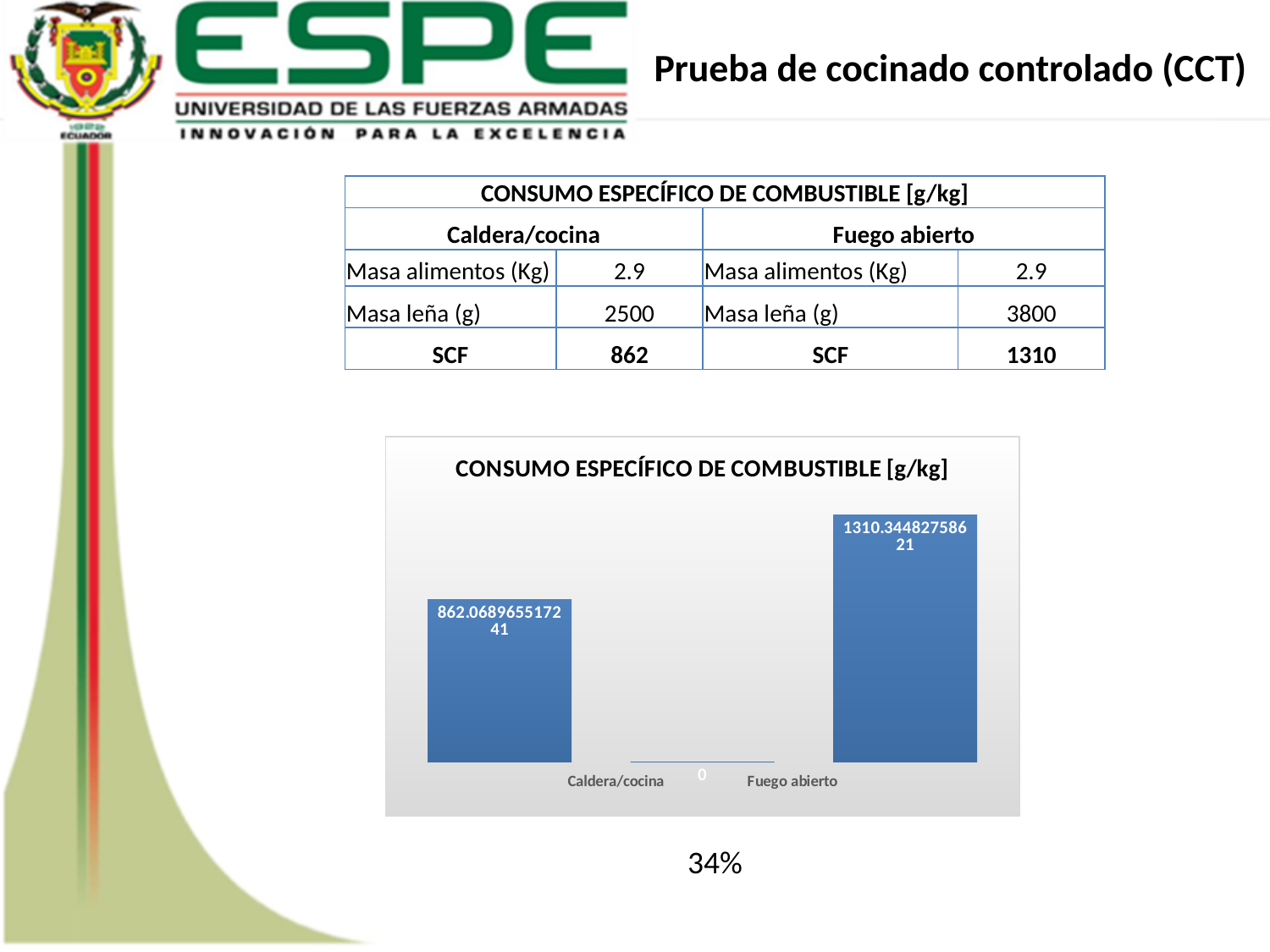
Is the value for Fuego abierto larger or smaller than the value for Caldera/cocina? Larger What is the title of the chart? CONSUMO ESPECÍFICO DE COMBUSTIBLE [g/kg] Do the values rise or fall going from Caldera/cocina to Fuego abierto? Rise Which of the two labelled categories, Caldera/cocina or Fuego abierto, has the lower value? Caldera/cocina What colour are the bars in the chart? Blue What type of chart is shown on the slide? Bar chart What is the value shown for Fuego abierto in the chart? 1310.34482758621 What is the value shown for Caldera/cocina in the chart? 862.068965517241 Which category has the highest value in the chart? Fuego abierto What is the difference between the Fuego abierto value and the Caldera/cocina value in the chart? 448.275862068969